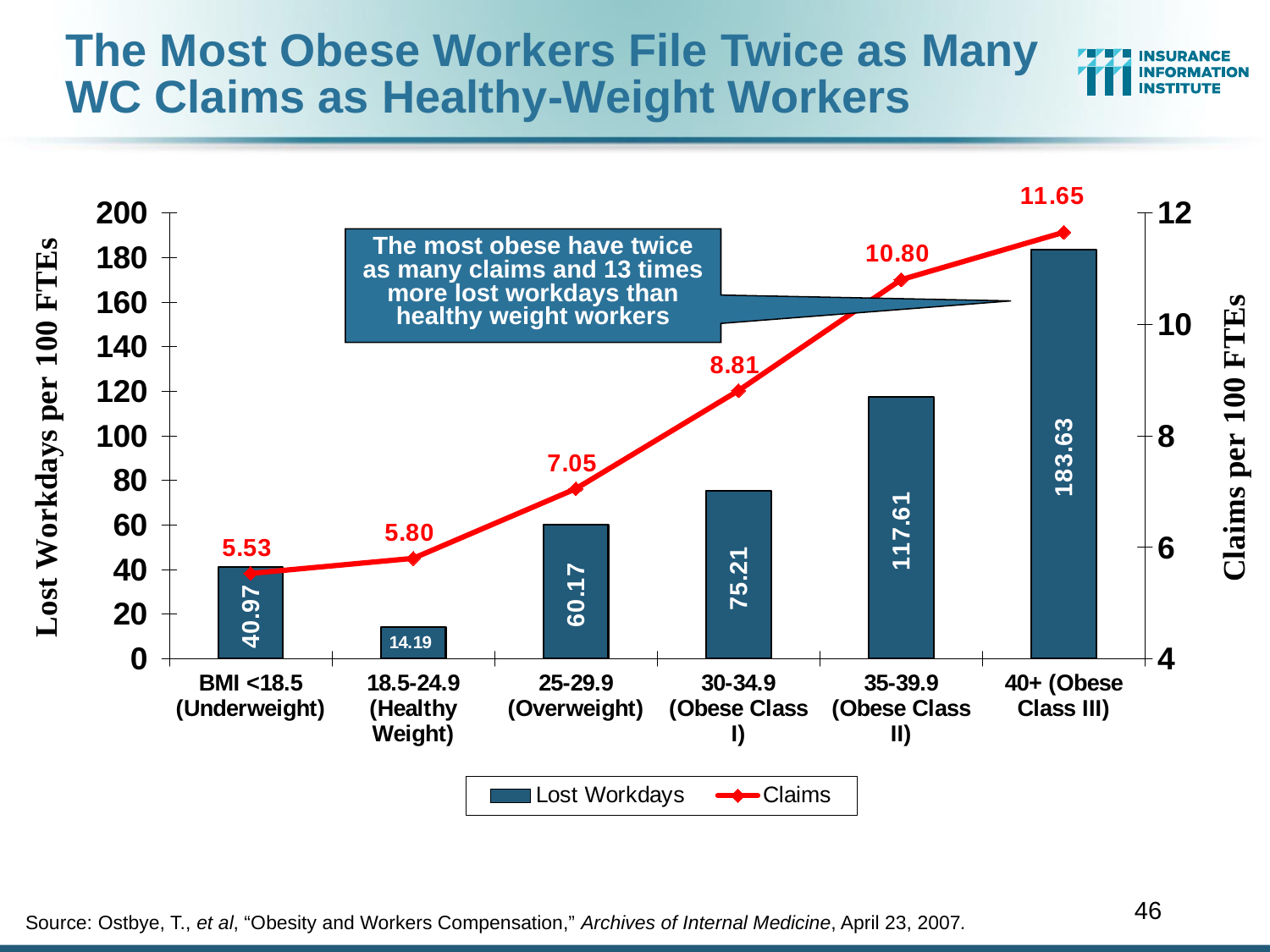
What is the Lost Workdays value for the 30-34.9 (Obese Class I) category? 75.21 Do the Claims values rise or fall as BMI increases along the x axis? rise What is the difference in Claims between the 40+ (Obese Class III) and 18.5-24.9 (Healthy Weight) categories? 5.85 Which has a higher Lost Workdays value: BMI <18.5 (Underweight) or 25-29.9 (Overweight)? 25-29.9 (Overweight) How many BMI categories are shown on the x axis? 6 What is the label of the right-hand vertical axis? Claims per 100 FTEs Which BMI category has the lowest Lost Workdays value? 18.5-24.9 (Healthy Weight) What is the Lost Workdays value for the 40+ (Obese Class III) category? 183.63 How many series does the legend list? 2 What is the Claims value for the 18.5-24.9 (Healthy Weight) category? 5.80 What is the difference in Lost Workdays between the 35-39.9 (Obese Class II) and 25-29.9 (Overweight) categories? 57.44 Which BMI category has the highest Claims value? 40+ (Obese Class III)